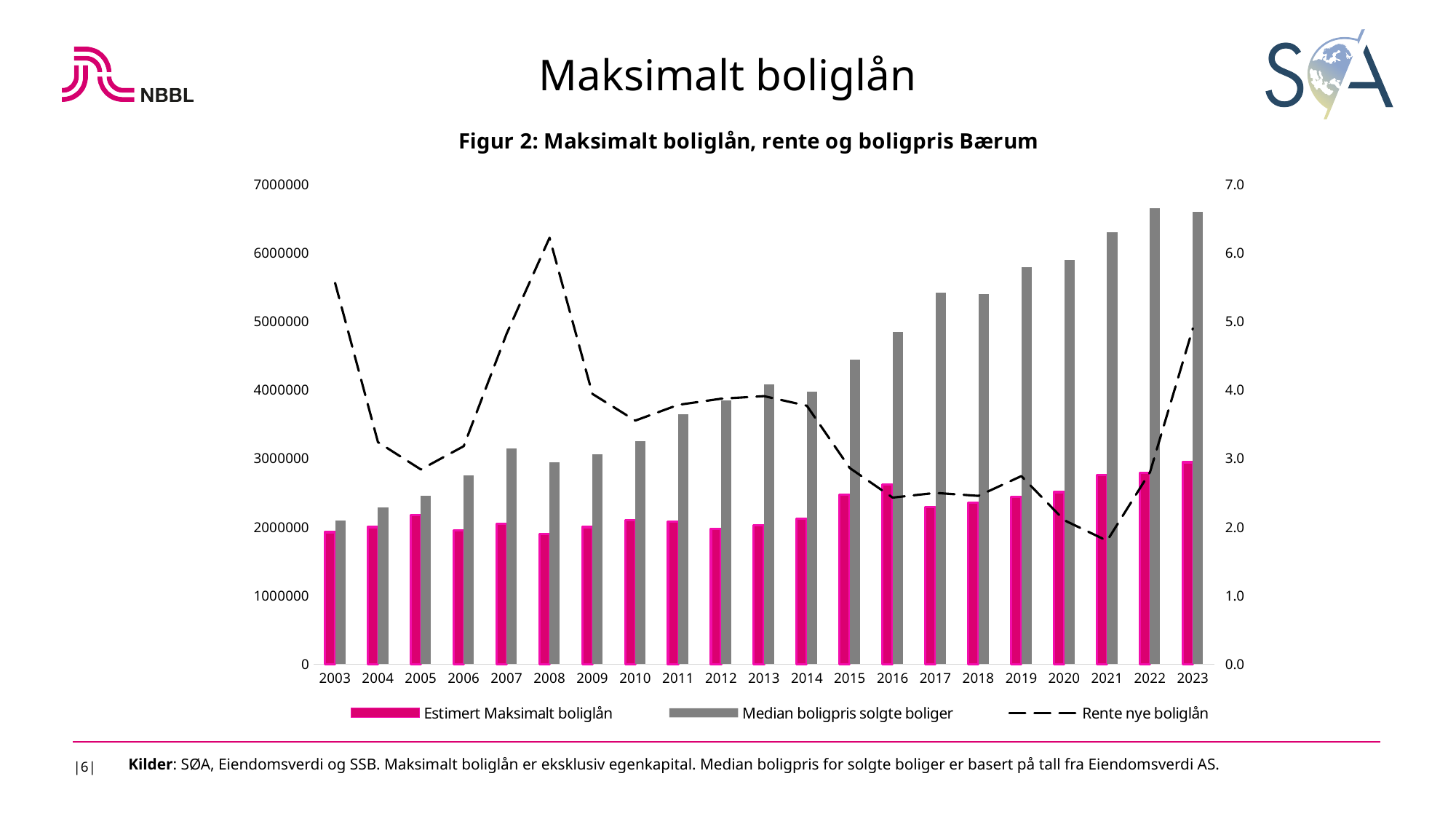
Which is larger, Estimert Maksimalt boliglån in 2016 or in 2017? 2016 Is the Rente nye boliglån for 2021 greater or less than 2.0? less How many years are shown on the x axis? 21 In which year is Median boligpris solgte boliger lowest? 2003 Is the Median boligpris solgte boliger for 2010 greater or less than 3000000? greater How many series does the legend list? 3 In which year is Rente nye boliglån highest? 2008 Is the Median boligpris solgte boliger for 2015 greater or less than 4000000? greater In which year is Rente nye boliglån lowest? 2021 Does Median boligpris solgte boliger generally rise or fall from 2003 to 2023? rise What kind of chart is shown on the slide? A combined bar and line chart In which year is Estimert Maksimalt boliglån highest? 2023